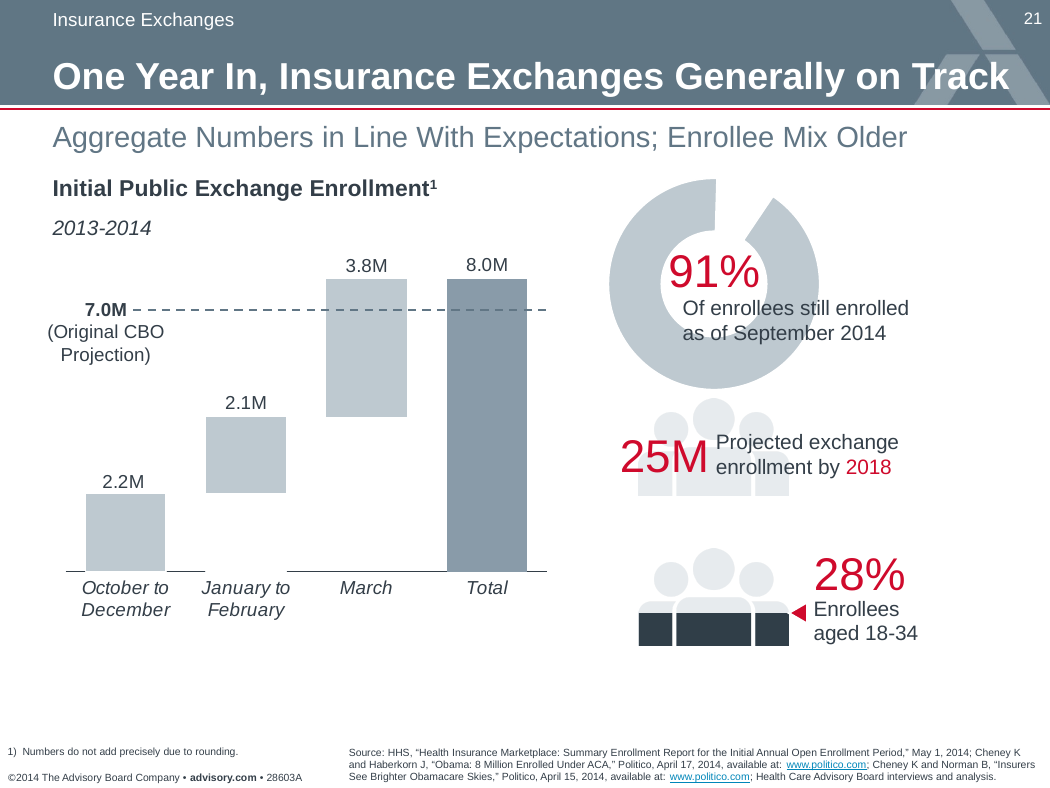
In the Initial Public Exchange Enrollment chart, which is larger: the value for March or the value for January to February? March How many categories are shown on the x axis of the Initial Public Exchange Enrollment chart? 4 In the Initial Public Exchange Enrollment chart, which of the three enrollment periods has the highest value? March What value does the dashed horizontal line in the Initial Public Exchange Enrollment chart represent? 7.0M (Original CBO Projection) In the Initial Public Exchange Enrollment chart, what is the difference between the March value and the October to December value? 1.6M In the Initial Public Exchange Enrollment chart, what is the value for January to February? 2.1M What kind of chart is the Initial Public Exchange Enrollment chart? Bar chart In the Initial Public Exchange Enrollment chart, what is the value for October to December? 2.2M In the Initial Public Exchange Enrollment chart, what is the value shown for Total? 8.0M In the Initial Public Exchange Enrollment chart, what is the value for March? 3.8M In the Initial Public Exchange Enrollment chart, by how much does the Total exceed the Original CBO Projection of 7.0M? 1.0M In the Initial Public Exchange Enrollment chart, which of the three enrollment periods has the lowest value? January to February